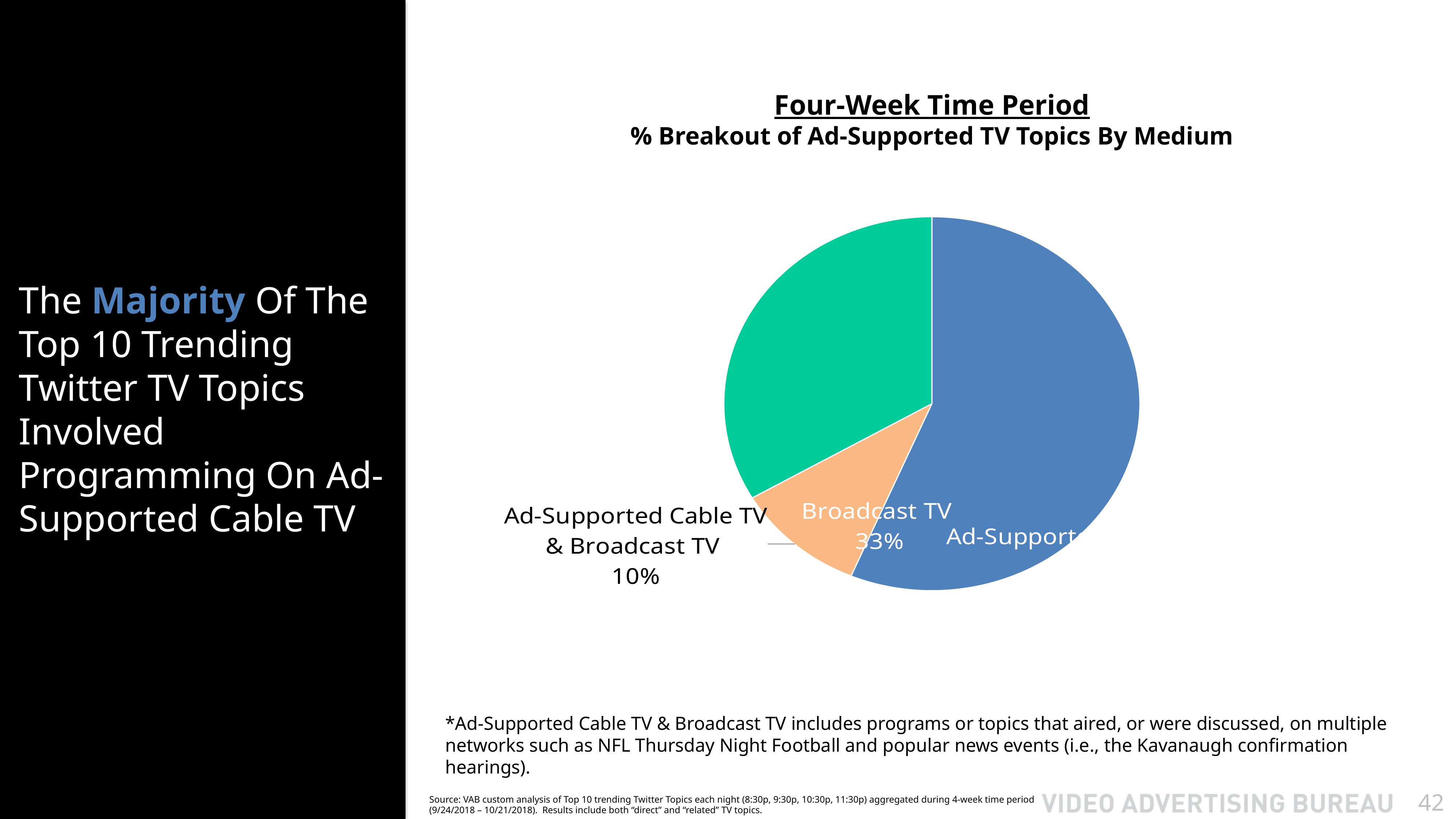
Which slice of the pie chart is the largest? Ad-Supported Cable TV What colour is the Broadcast TV slice of the pie chart? green How many slices does the pie chart have? 3 What percentage of ad-supported TV topics is attributed to Broadcast TV? 33% Which slice of the pie chart is the smallest? Ad-Supported Cable TV & Broadcast TV What is the underlined title above the pie chart? Four-Week Time Period What kind of chart is shown on the slide? pie chart By how many percentage points does the Broadcast TV share exceed the Ad-Supported Cable TV & Broadcast TV share? 23 percentage points What percentage is shown for the Ad-Supported Cable TV & Broadcast TV slice? 10% Which is larger: the Broadcast TV slice or the Ad-Supported Cable TV & Broadcast TV slice? Broadcast TV